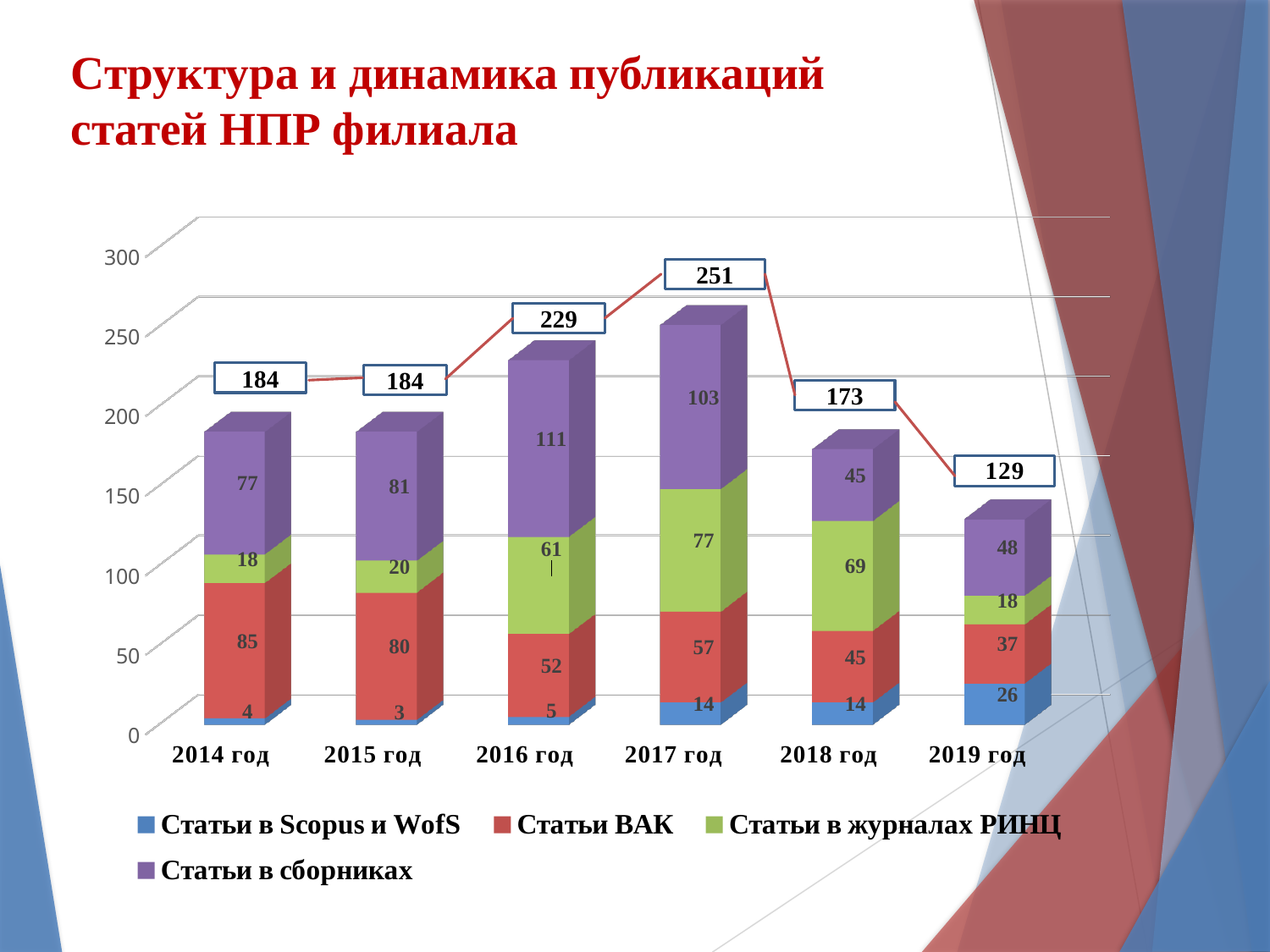
Which year has the highest total number of publications? 2017 год What is the total of the stacked bar for 2017 год? 251 What is the difference between the totals for 2017 год and 2018 год? 78 What is the value for "Статьи ВАК" in 2014 год? 85 Which is larger: "Статьи в журналах РИНЦ" in 2017 год or in 2018 год? 2017 год Do the total values rise or fall from 2017 год to 2019 год? Fall Which year has the lowest total number of publications? 2019 год What is the value for "Статьи в сборниках" in 2016 год? 111 What is the value for "Статьи в Scopus и WofS" in 2019 год? 26 How many years are shown on the x axis? 6 What kind of chart is shown on the slide? Stacked bar chart How many series does the legend list? 4